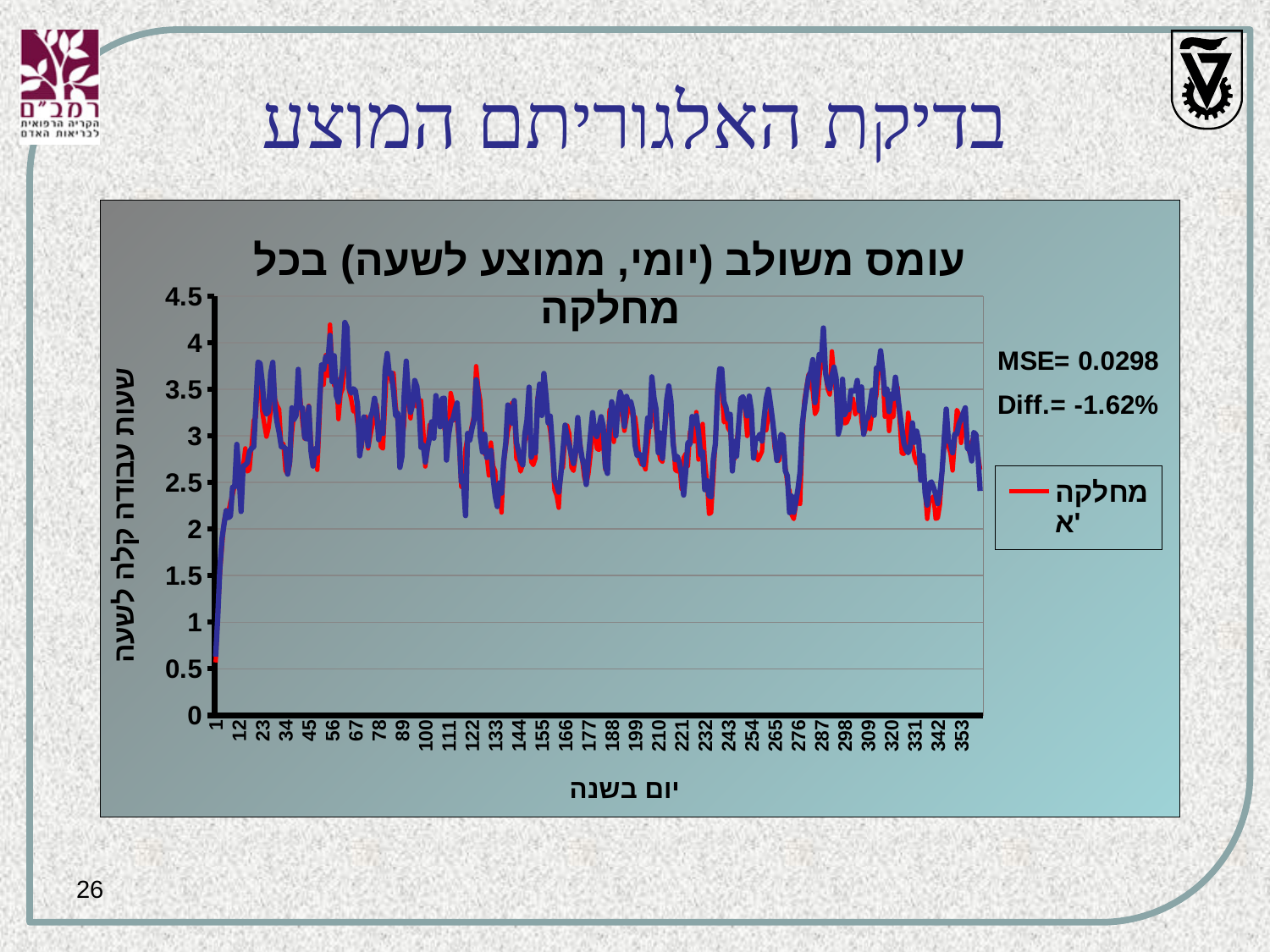
Is the highest peak of the plotted lines greater or less than 4? greater What MSE value is printed next to the chart? 0.0298 Is the dip in the lines near day 276 greater or less than 2.5? less What kind of chart is shown on the slide? line chart What is the label of the series listed in the legend? מחלקה א' Do the values rise or fall between day 1 and day 23? rise How many series does the chart's legend list? 1 What is the highest value shown on the y axis? 4.5 What is the title of the chart? עומס משולב (יומי, ממוצע לשעה) בכל מחלקה Is the value at day 23 greater or less than 3? greater What Diff. value is printed next to the chart? -1.62%